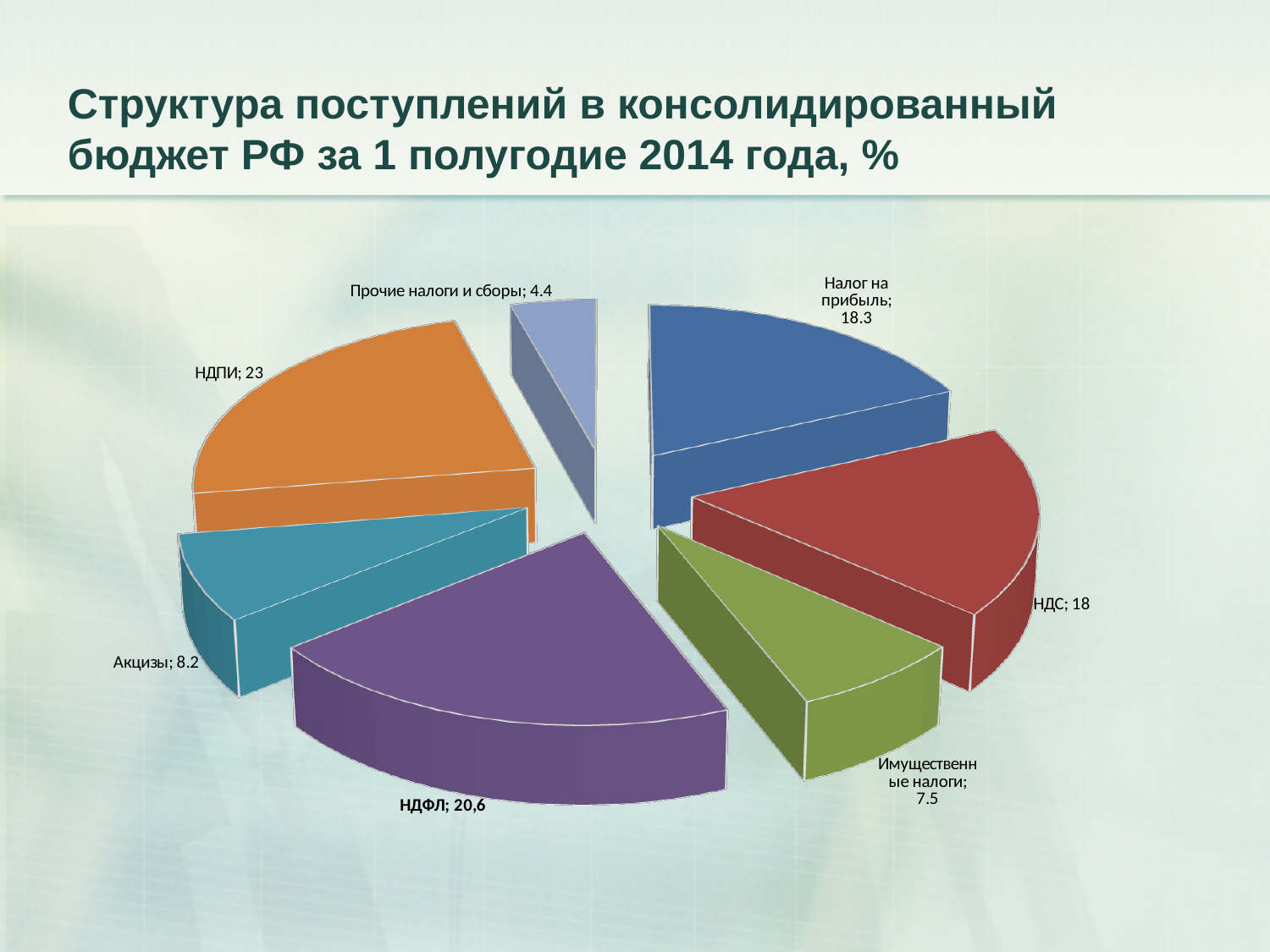
What is the value for НДПИ? 23 What is the value for Прочие налоги и сборы? 4.4 What is the value for Налог на прибыль? 18.3 What type of chart is shown on the slide? pie chart Which is larger, the value for НДПИ or the value for НДФЛ? НДПИ What is the value for НДФЛ? 20,6 How many slices does the pie chart have? 7 What is the difference between the values for НДПИ and Прочие налоги и сборы? 18.6 What is the value for Имущественные налоги? 7.5 What is the title of the chart on the slide? Структура поступлений в консолидированный бюджет РФ за 1 полугодие 2014 года, % Which category has the smallest slice of the pie? Прочие налоги и сборы Which category has the largest slice of the pie? НДПИ